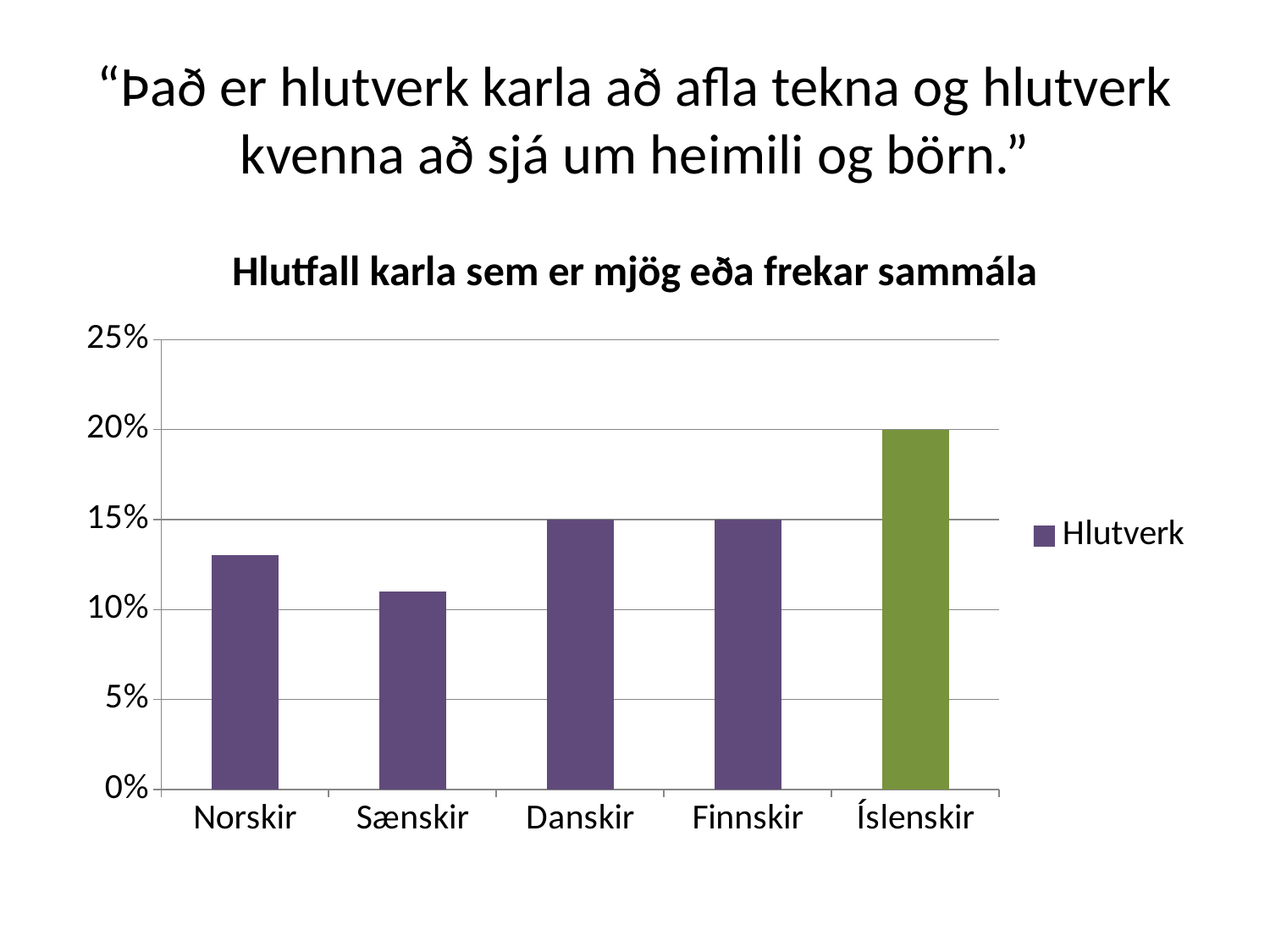
What is the title of the chart? Hlutfall karla sem er mjög eða frekar sammála What is the value for Íslenskir? 20% Which category has the lowest value? Sænskir What is the value for Danskir? 15% How many categories are shown on the x axis of the chart? 5 Is the value for Norskir greater or less than 15%? less What is the name of the series in the legend? Hlutverk What kind of chart is shown on the slide? bar chart How many series does the legend list? 1 Which category has the highest value? Íslenskir Is the value for Sænskir greater or less than 10%? greater Which is larger, the value for Norskir or the value for Sænskir? Norskir